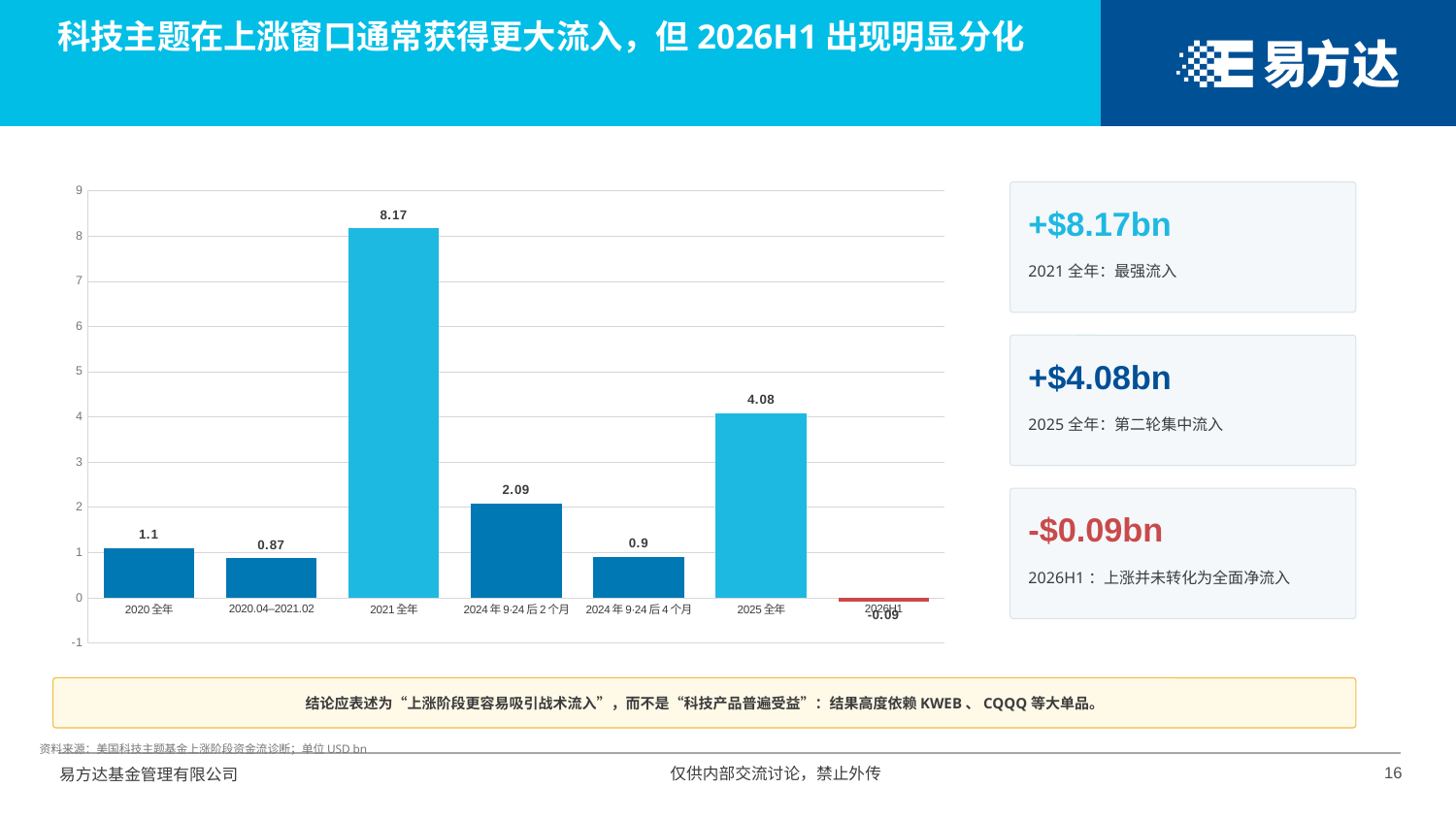
Is the value for 2025 全年 greater or less than 4? greater How many categories are shown on the x axis? 7 What kind of chart is shown on the slide? bar chart Which category has the highest value? 2021 全年 Which is larger, the value for 2020 全年 or the value for 2020.04–2021.02? 2020 全年 Which category has the lowest value? 2026H1 What is the difference between the values for 2021 全年 and 2025 全年? 4.09 What is the value for 2025 全年? 4.08 What is the value for 2026H1? -0.09 What is the value for 2021 全年? 8.17 What is the value for 2024 年 9·24 后 2 个月? 2.09 What is the difference between the values for 2024 年 9·24 后 2 个月 and 2024 年 9·24 后 4 个月? 1.19